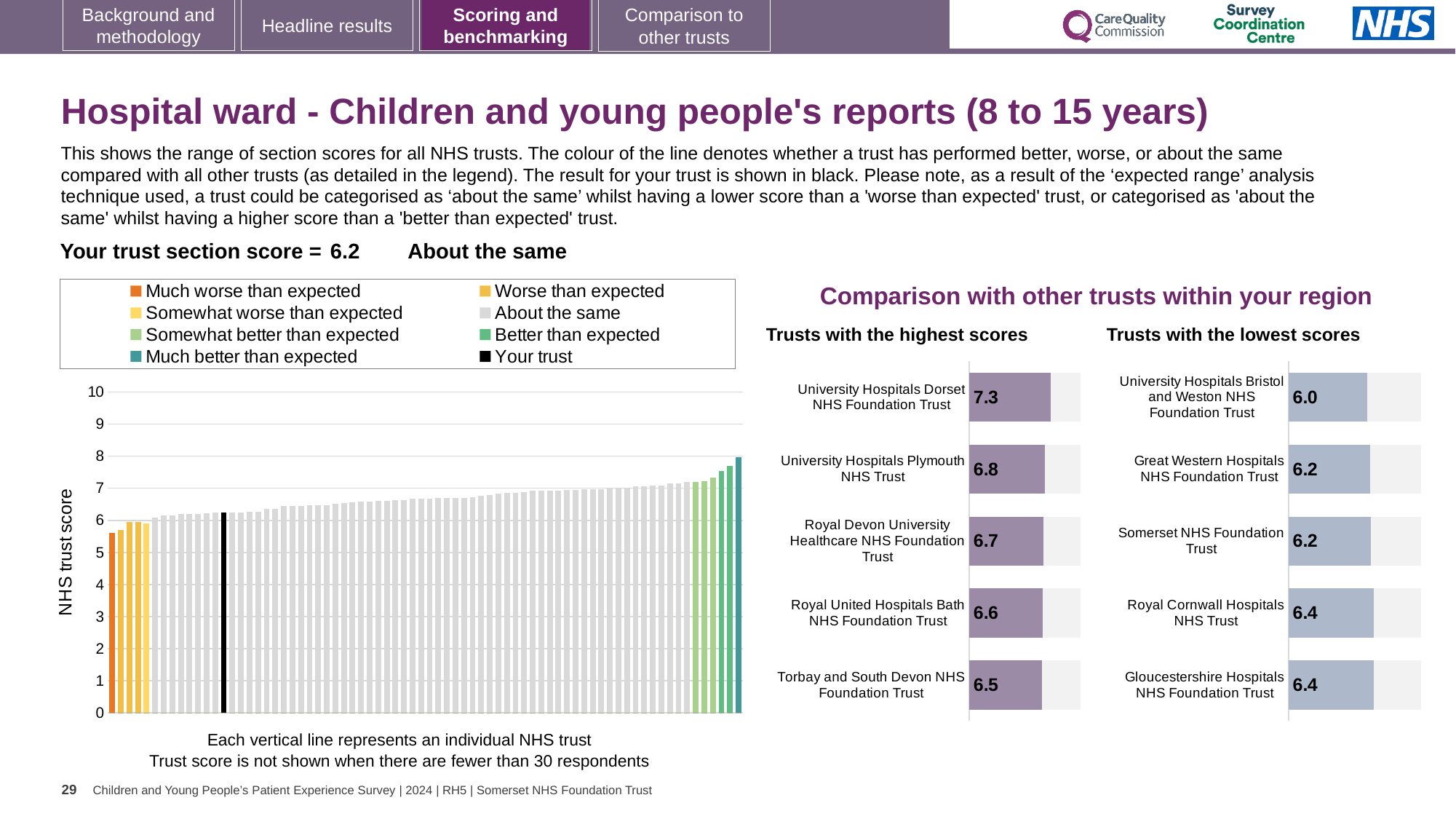
In the 'Trusts with the lowest scores' chart, what is the score for University Hospitals Bristol and Weston NHS Foundation Trust? 6.0 In the 'Trusts with the highest scores' chart, what is the score for University Hospitals Dorset NHS Foundation Trust? 7.3 In the left-hand NHS trust score chart, is the value for the black 'Your trust' bar greater or less than 7? less How many trusts are shown in the 'Trusts with the highest scores' chart? 5 How many entries does the legend of the left-hand NHS trust score chart list? 8 In the 'Trusts with the lowest scores' chart, what is the score for Somerset NHS Foundation Trust? 6.2 In the 'Trusts with the lowest scores' chart, which trust has the lowest score? University Hospitals Bristol and Weston NHS Foundation Trust In the 'Trusts with the highest scores' chart, which has the higher score: University Hospitals Plymouth NHS Trust or Royal Devon University Healthcare NHS Foundation Trust? University Hospitals Plymouth NHS Trust In the 'Trusts with the highest scores' chart, what is the difference between the scores of University Hospitals Dorset NHS Foundation Trust and Torbay and South Devon NHS Foundation Trust? 0.8 What kind of chart is the large chart on the left showing NHS trust scores? Bar chart In the 'Trusts with the lowest scores' chart, what is the difference between the scores of Royal Cornwall Hospitals NHS Trust and University Hospitals Bristol and Weston NHS Foundation Trust? 0.4 In the 'Trusts with the highest scores' chart, which trust has the lowest score? Torbay and South Devon NHS Foundation Trust